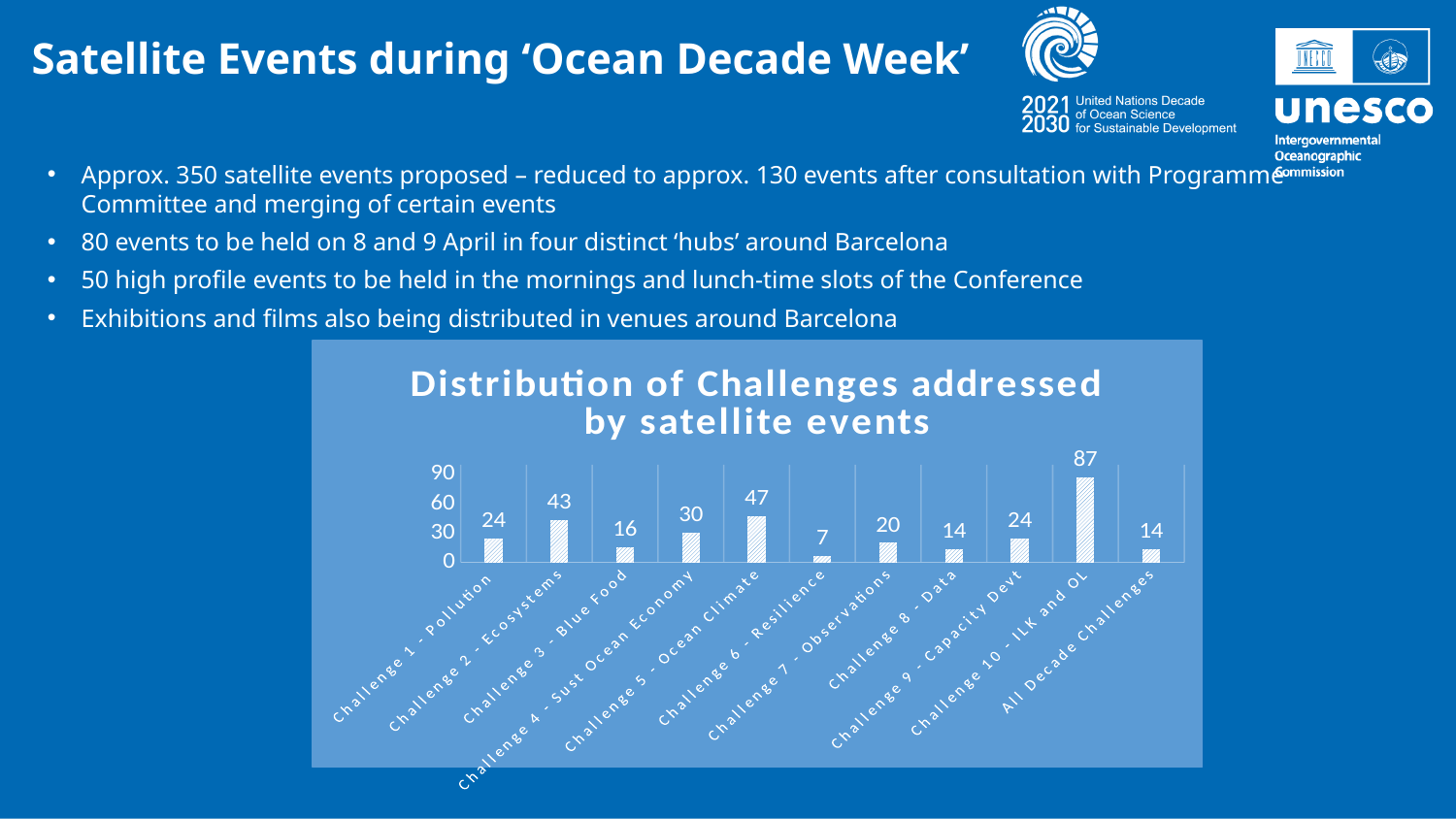
Which category has the lowest value? Challenge 6 - Resilience What is the title of the chart? Distribution of Challenges addressed by satellite events What is the value for Challenge 10 - ILK and OL? 87 How many categories are shown on the x axis? 11 Which is larger, the value for Challenge 2 - Ecosystems or Challenge 4 - Sust Ocean Economy? Challenge 2 - Ecosystems Is the value for Challenge 7 - Observations greater or less than 30? less What is the value for All Decade Challenges? 14 What is the value for Challenge 3 - Blue Food? 16 Which category has the highest value? Challenge 10 - ILK and OL What is the difference between the values for Challenge 10 - ILK and OL and Challenge 5 - Ocean Climate? 40 What is the value for Challenge 5 - Ocean Climate? 47 What kind of chart is shown on the slide? Bar chart